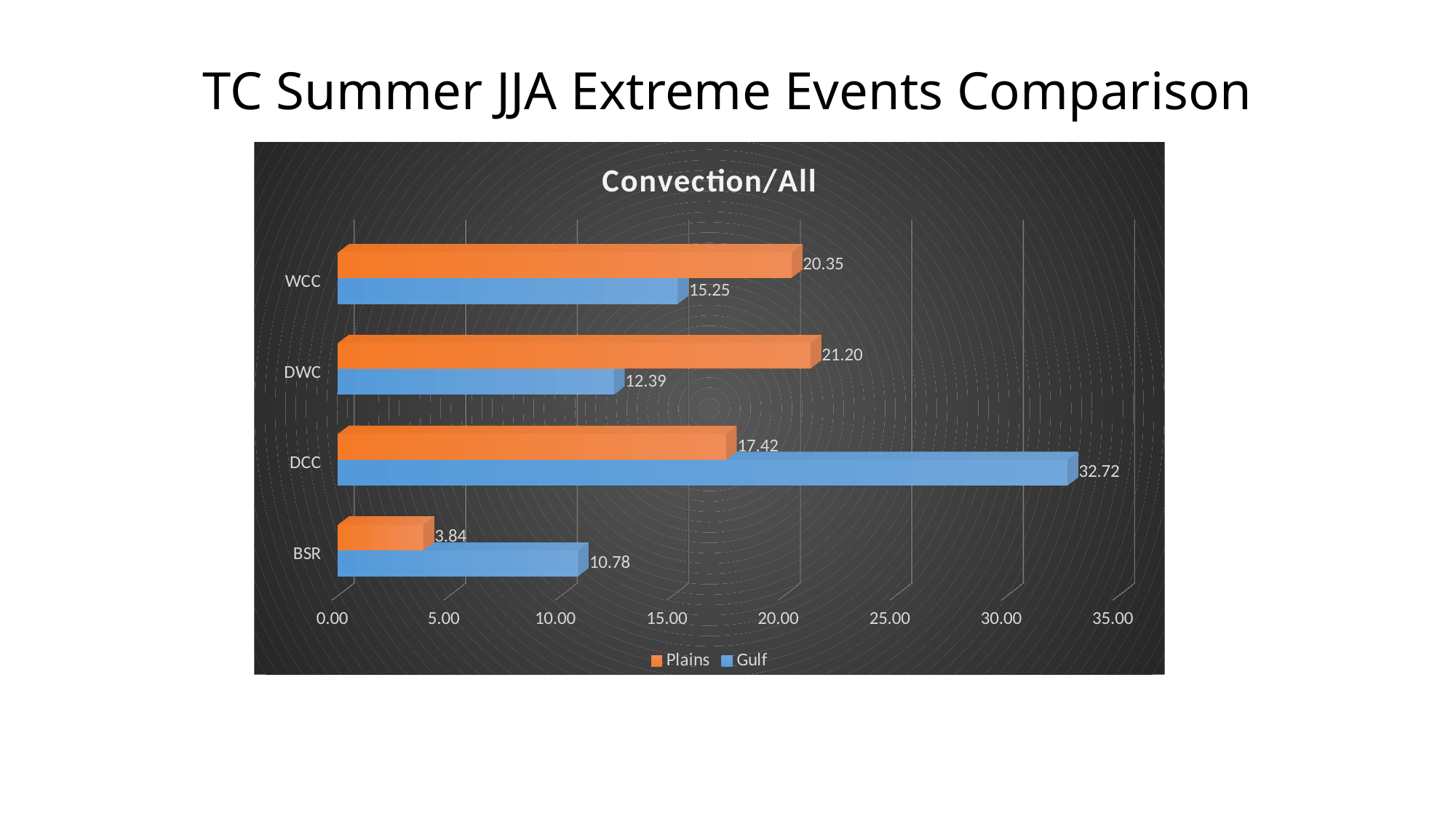
How many categories are shown on the chart? 4 What is the Plains value for DWC? 21.20 What is the difference between the Plains and Gulf values for DWC? 8.81 What is the Gulf value for DCC? 32.72 What is the Gulf value for BSR? 10.78 Which is larger for DCC, the Plains value or the Gulf value? Gulf Which category has the highest Gulf value? DCC Which category has the lowest Plains value? BSR What is the Plains value for WCC? 20.35 How many series does the legend list? 2 What is the title of the chart? Convection/All What kind of chart is shown? Bar chart